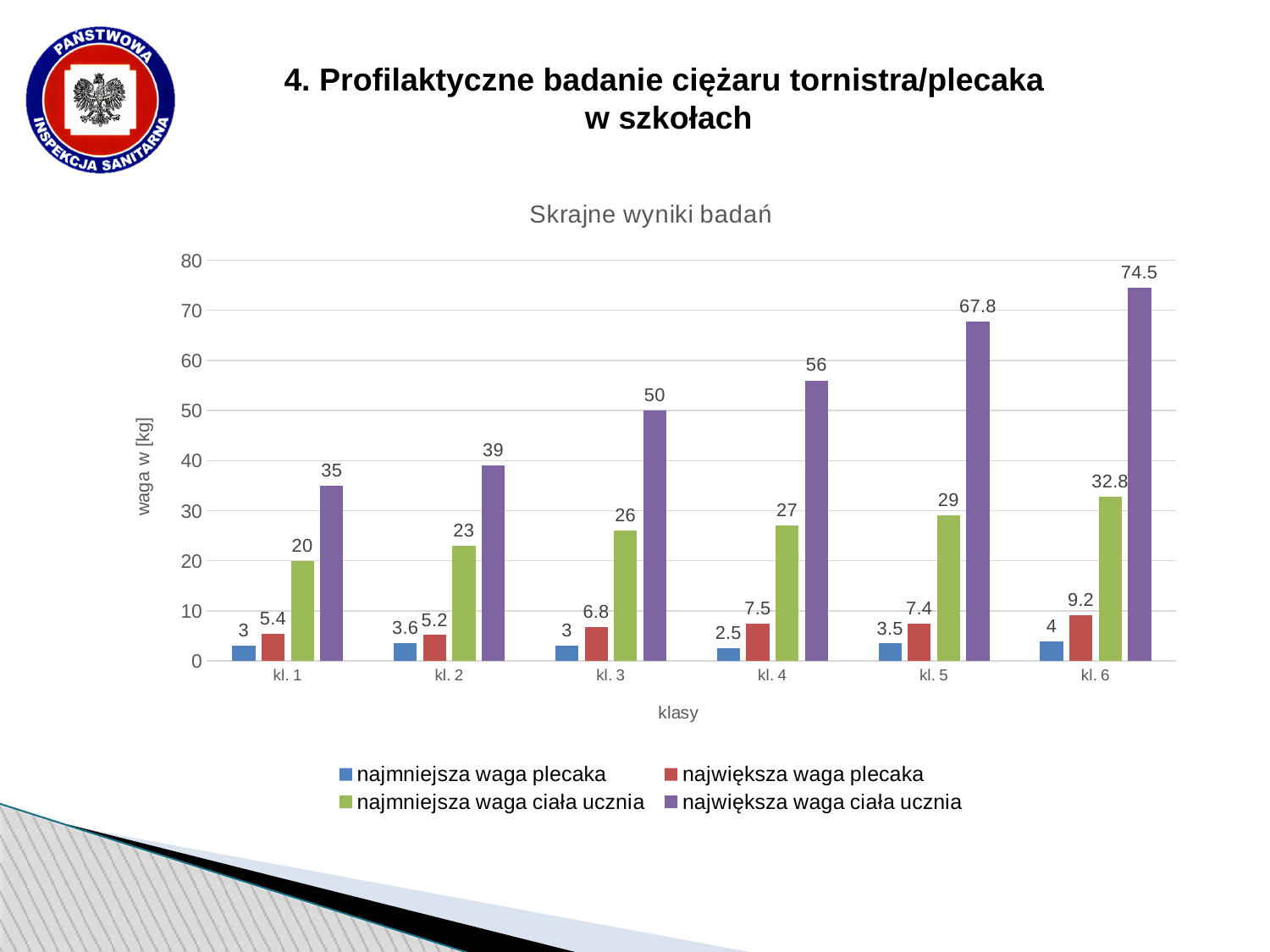
What kind of chart is shown on the slide? bar chart Which class has the lowest value for 'najmniejsza waga plecaka'? kl. 4 What is the value of 'najmniejsza waga plecaka' for kl. 4? 2.5 What is the difference between 'największa waga ciała ucznia' and 'najmniejsza waga ciała ucznia' for kl. 5? 38.8 What is the value of 'największa waga plecaka' for kl. 3? 6.8 Which is larger: 'największa waga plecaka' for kl. 4 or for kl. 5? kl. 4 What is the value of 'największa waga ciała ucznia' for kl. 6? 74.5 How many series does the legend list? 4 What is the value of 'najmniejsza waga ciała ucznia' for kl. 2? 23 Which class has the highest value for 'największa waga plecaka'? kl. 6 How many classes (categories) are shown on the x axis? 6 Does 'największa waga ciała ucznia' rise or fall from kl. 1 to kl. 6? rise